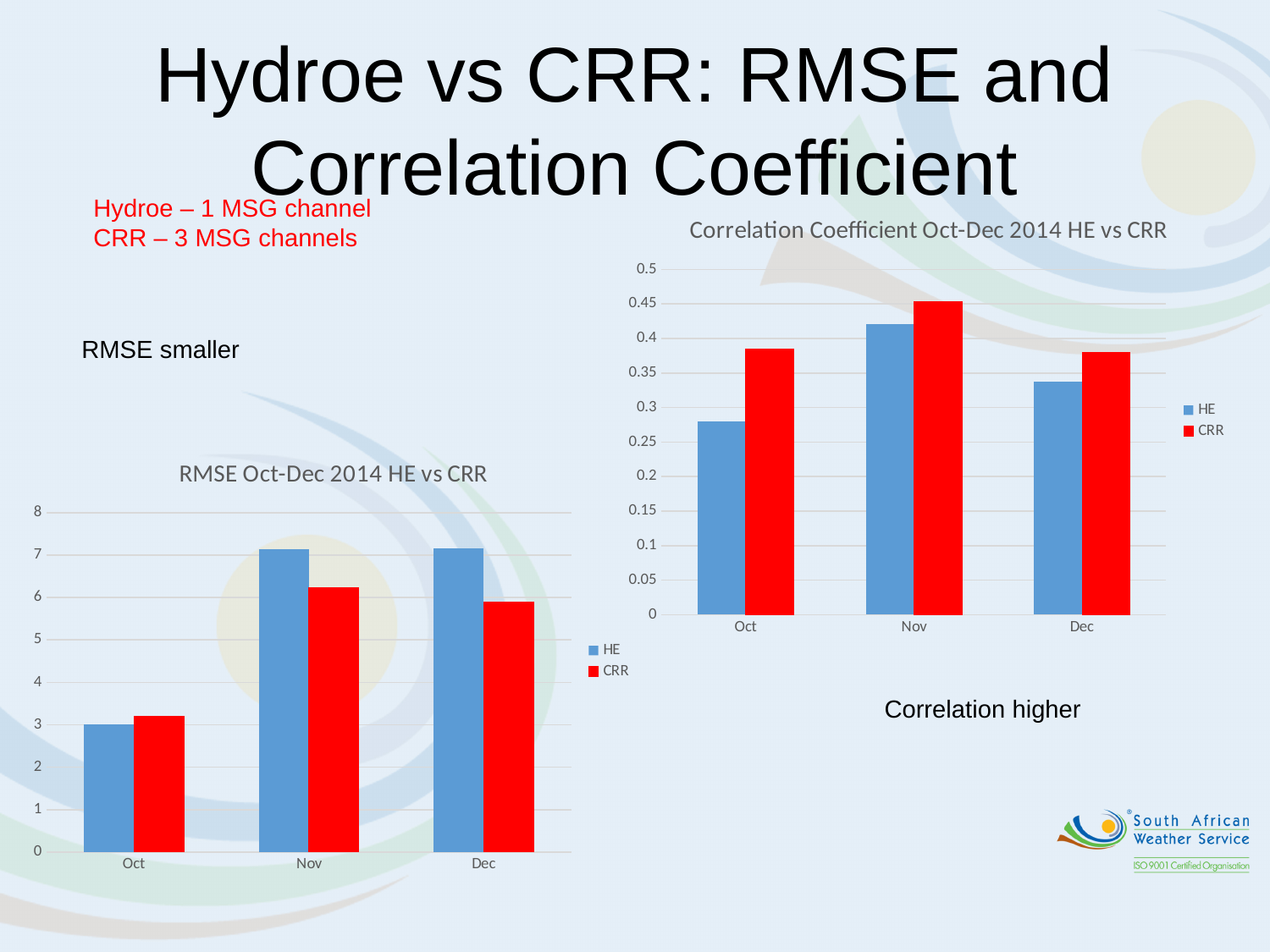
In the RMSE Oct-Dec 2014 HE vs CRR chart, which series has the larger value for Nov, HE or CRR? HE In the RMSE Oct-Dec 2014 HE vs CRR chart, how many months are shown on the x axis? 3 In the RMSE Oct-Dec 2014 HE vs CRR chart, which month has the lowest HE value? Oct In the RMSE Oct-Dec 2014 HE vs CRR chart, is the CRR value for Dec greater or less than 6? less In the RMSE Oct-Dec 2014 HE vs CRR chart, is the HE value for Nov greater or less than 7? greater In the RMSE Oct-Dec 2014 HE vs CRR chart, what kind of chart is shown? bar chart In the Correlation Coefficient Oct-Dec 2014 HE vs CRR chart, which series has the larger value for Oct, HE or CRR? CRR In the Correlation Coefficient Oct-Dec 2014 HE vs CRR chart, what colour are the CRR bars? red In the RMSE Oct-Dec 2014 HE vs CRR chart, how many series does the legend list? 2 In the Correlation Coefficient Oct-Dec 2014 HE vs CRR chart, is the HE value for Oct greater or less than 0.3? less In the Correlation Coefficient Oct-Dec 2014 HE vs CRR chart, which month has the highest CRR value? Nov